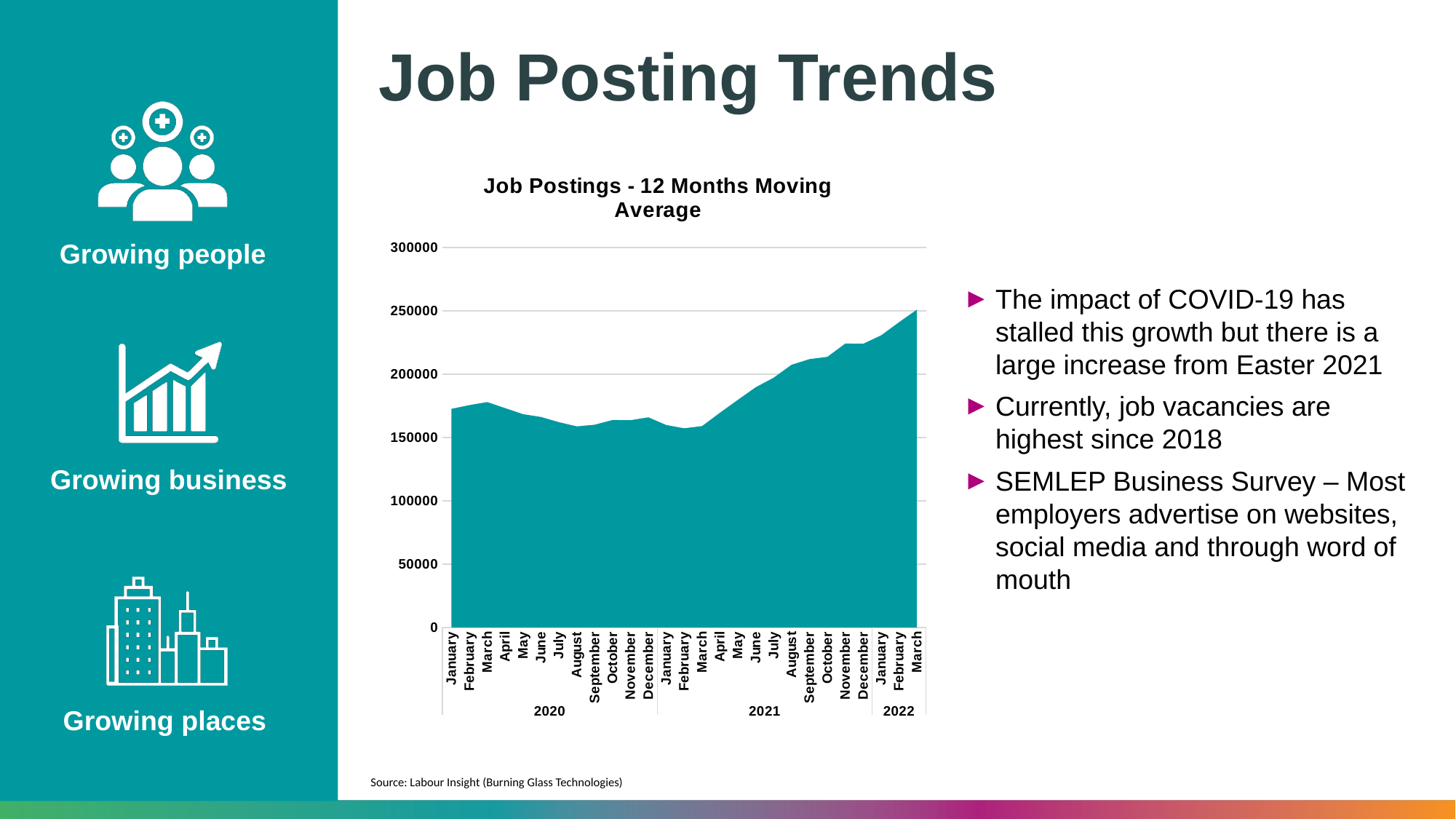
Which is larger, the value for January 2021 or the value for December 2021? December 2021 What is the highest value shown on the vertical axis? 300000 How many monthly data points are plotted in the chart? 27 Is the value for January 2020 greater or less than 150000? greater What is the title of the chart? Job Postings - 12 Months Moving Average Is the value for October 2021 greater or less than 200000? greater What kind of chart is shown on the slide? Area chart Do the values rise or fall from March 2021 to March 2022? Rise Which is larger, the value for January 2020 or the value for March 2022? March 2022 Which month has the highest value in the chart? March 2022 Is the value for February 2021 greater or less than 200000? less